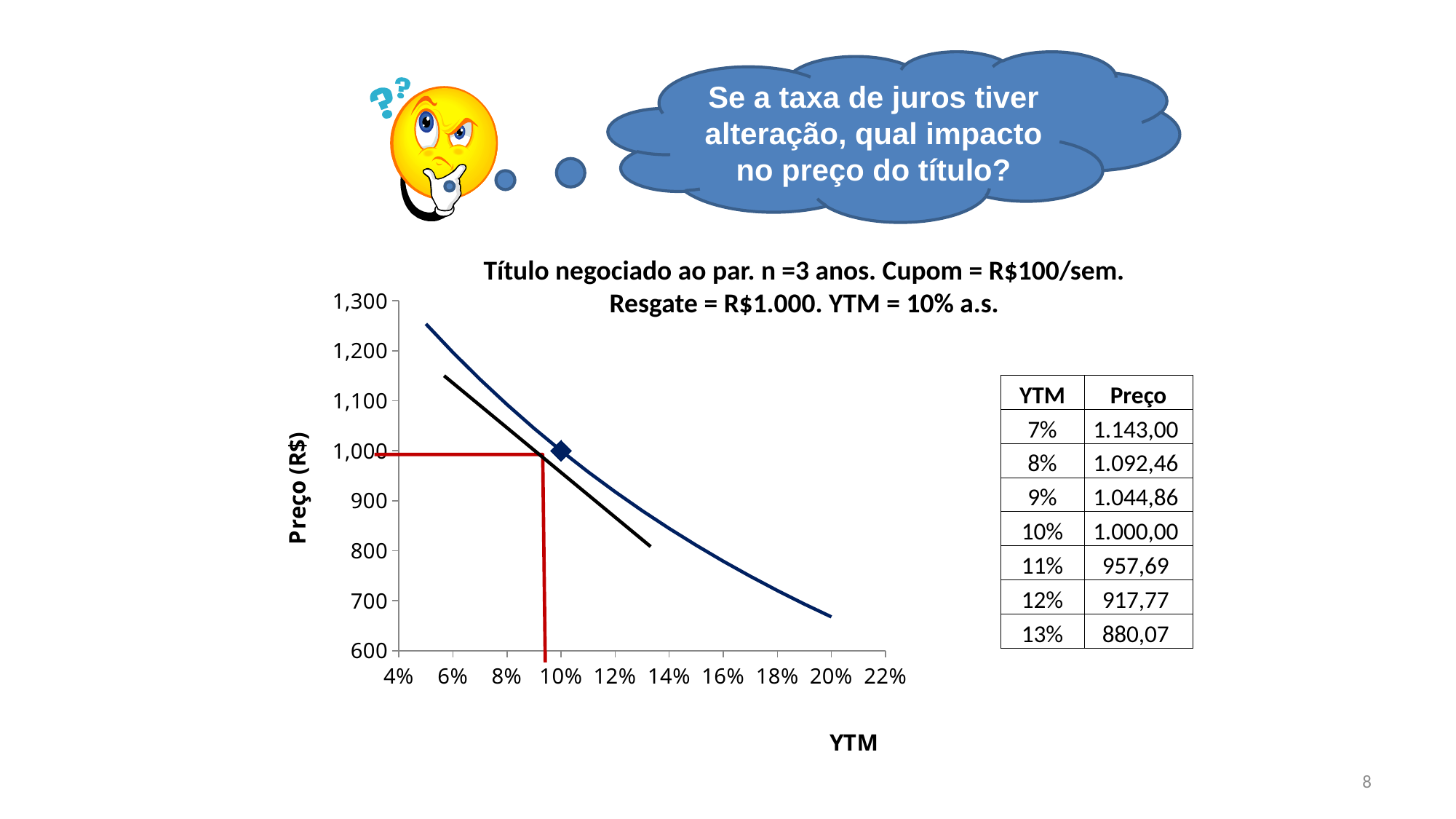
Using the table values, what is the difference between the Preço at 7% YTM and at 13% YTM? 262,93 Which YTM has the higher Preço in the table, 8% or 12%? 8% What is the price marked by the highlighted point at a YTM of 10%? 1,000 Is the price on the curve at a YTM of 14% greater or less than 800? greater Is the price on the curve at a YTM of 6% greater or less than 1,100? greater What kind of chart is shown on the slide? line chart According to the table next to the chart, what is the Preço for a YTM of 7%? 1.143,00 Does the price (Preço) rise or fall as YTM increases along the x axis? fall What is the title of the vertical axis of the chart? Preço (R$) How many YTM values are listed in the table next to the chart? 7 Is the price on the curve at a YTM of 20% greater or less than 700? less According to the table next to the chart, what is the Preço for a YTM of 13%? 880,07